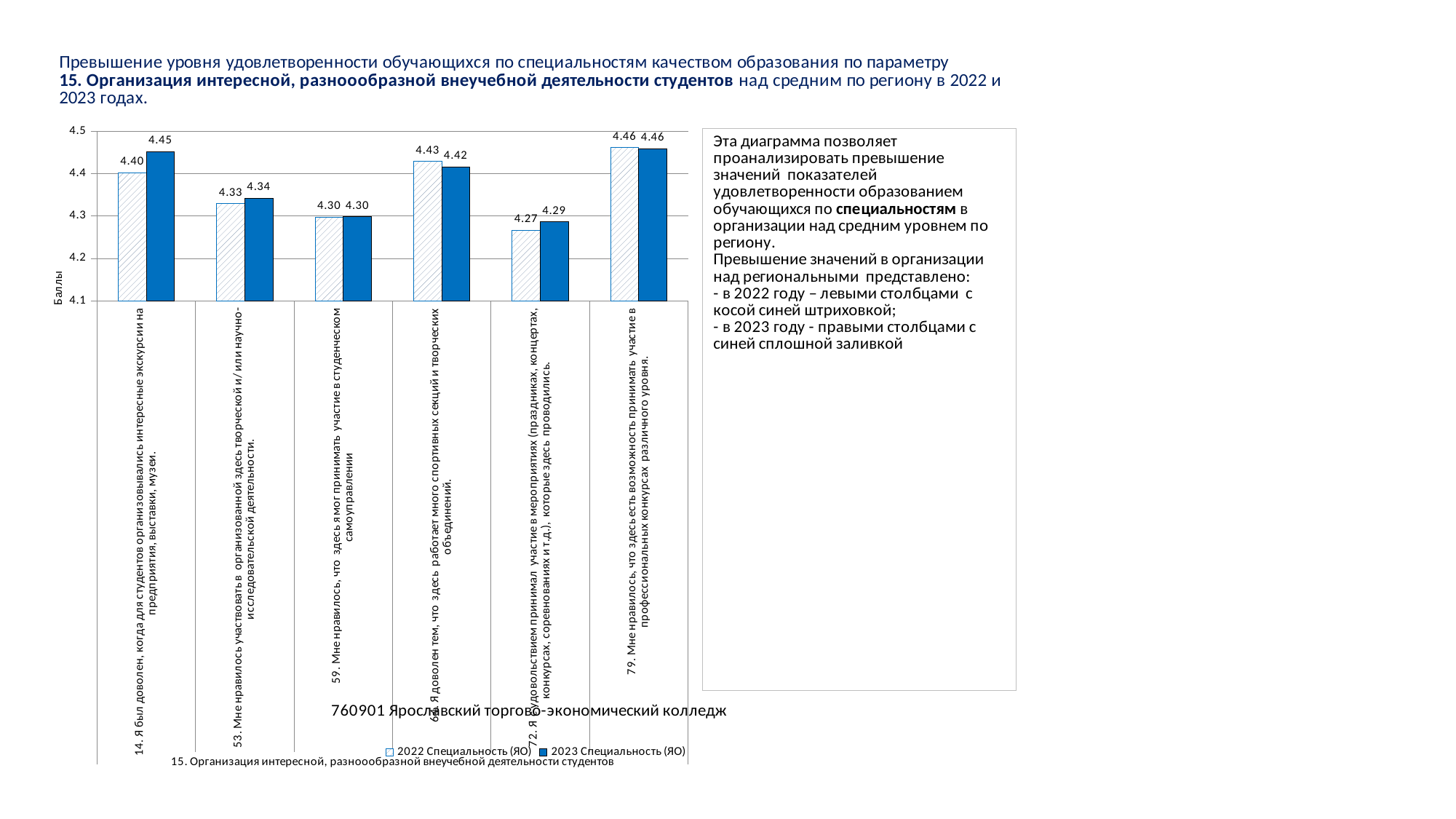
How many categories (questions) are shown on the chart? 6 What is the 2022 Специальность (ЯО) value for category 14 (интересные экскурсии на предприятия, выставки, музеи)? 4.40 How many series does the legend list? 2 What kind of chart is shown on the slide? bar chart Is the 2022 Специальность (ЯО) value for category 72 greater or less than 4.3? less What is the difference between the 2023 and 2022 Специальность (ЯО) values for category 14? 0.05 Which category has the highest 2023 Специальность (ЯО) value? 79. Мне нравилось, что здесь есть возможность принимать участие в профессиональных конкурсах различного уровня. What is the label of the vertical axis? Баллы Which category has the lowest 2022 Специальность (ЯО) value? 72. Я с удовольствием принимал участие в мероприятиях (праздниках, концертах, конкурсах, соревнованиях и т.д.), которые здесь проводились. What is the 2023 Специальность (ЯО) value for category 72 (участие в мероприятиях: праздниках, концертах, конкурсах, соревнованиях)? 4.29